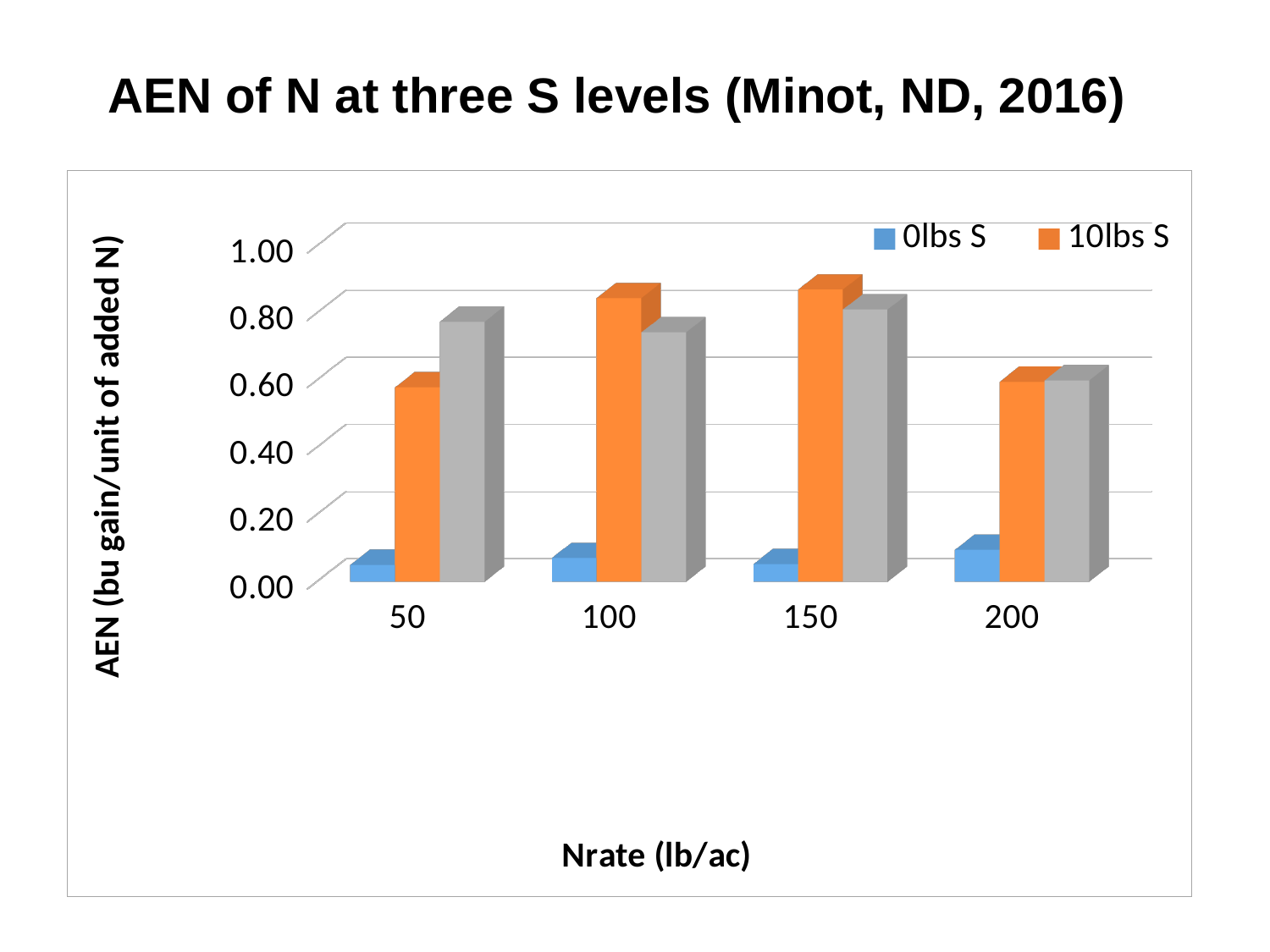
Does the 10lbs S value rise or fall from Nrate 150 to Nrate 200? fall Is the 0lbs S value at Nrate 200 greater or less than 0.20? less For the 10lbs S series, which is larger: the value at Nrate 100 or at Nrate 50? Nrate 100 Is the 10lbs S value at Nrate 100 greater or less than 0.60? greater What kind of chart is shown on the slide? Bar chart What is the label of the x axis? Nrate (lb/ac) At Nrate 150, which series has the larger value: 0lbs S or 10lbs S? 10lbs S How many Nrate categories are shown on the x axis? 4 How many series does the legend list? 2 What is the title of the chart? AEN of N at three S levels (Minot, ND, 2016) Is the 10lbs S value at Nrate 50 greater or less than 0.80? less